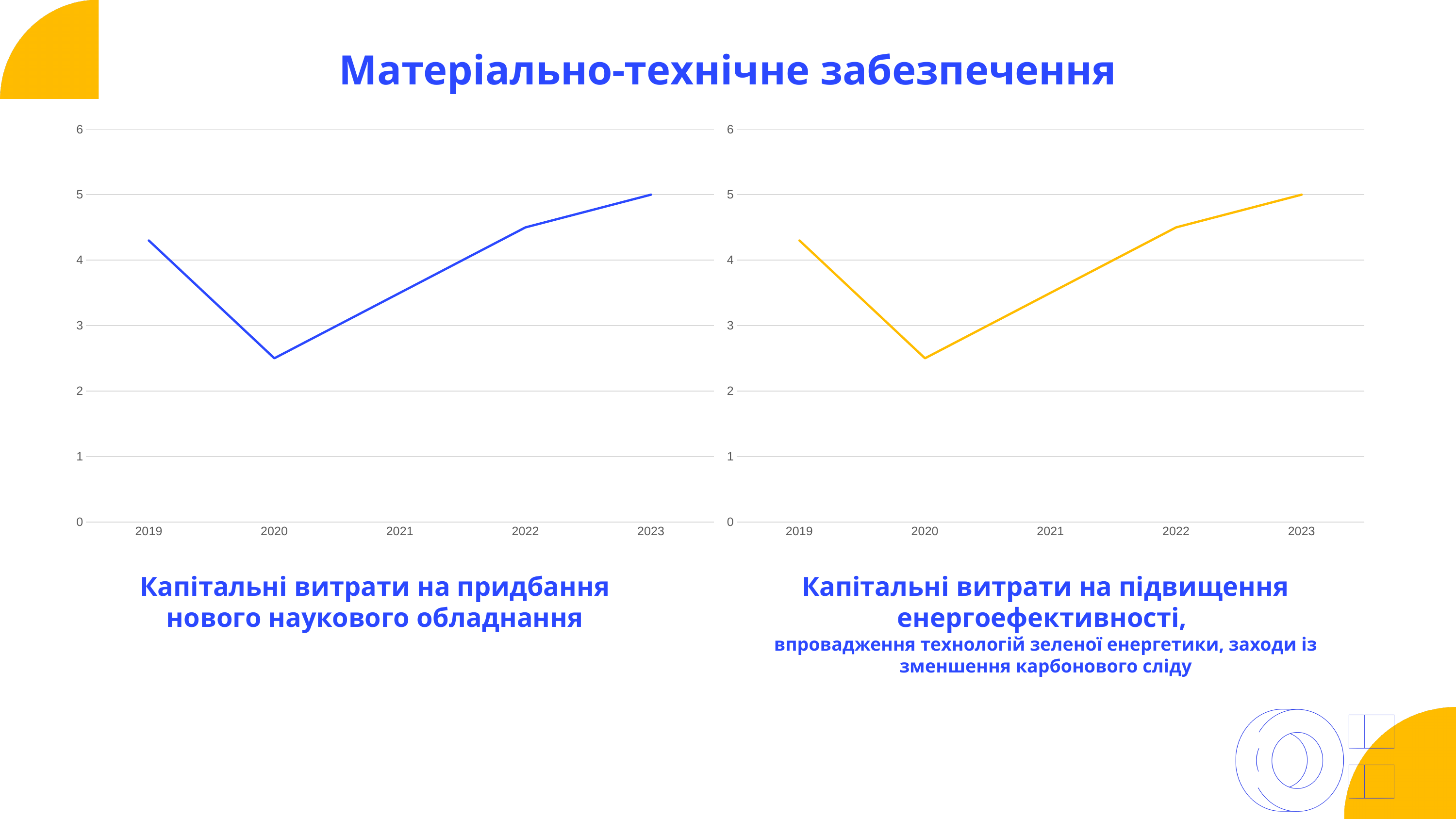
In the left chart, 'Капітальні витрати на придбання нового наукового обладнання', what is the value for 2023? 5 In the left chart, 'Капітальні витрати на придбання нового наукового обладнання', which year has the lowest value? 2020 What colour is the line in the right chart, 'Капітальні витрати на підвищення енергоефективності'? yellow In the right chart, 'Капітальні витрати на підвищення енергоефективності', which year has the highest value? 2023 In the right chart, 'Капітальні витрати на підвищення енергоефективності', is the value for 2020 greater or less than 3? less What kind of chart is the left chart, 'Капітальні витрати на придбання нового наукового обладнання'? line chart How many years are plotted on the x axis of the right chart, 'Капітальні витрати на підвищення енергоефективності'? 5 What is the title of the slide? Матеріально-технічне забезпечення In the right chart, 'Капітальні витрати на підвищення енергоефективності', is the value for 2022 greater or less than 4? greater In the right chart, 'Капітальні витрати на підвищення енергоефективності', do the values rise or fall from 2020 to 2023? rise In the left chart, 'Капітальні витрати на придбання нового наукового обладнання', is the value for 2019 greater or less than 4? greater In the left chart, 'Капітальні витрати на придбання нового наукового обладнання', which is larger, the value for 2019 or the value for 2020? 2019